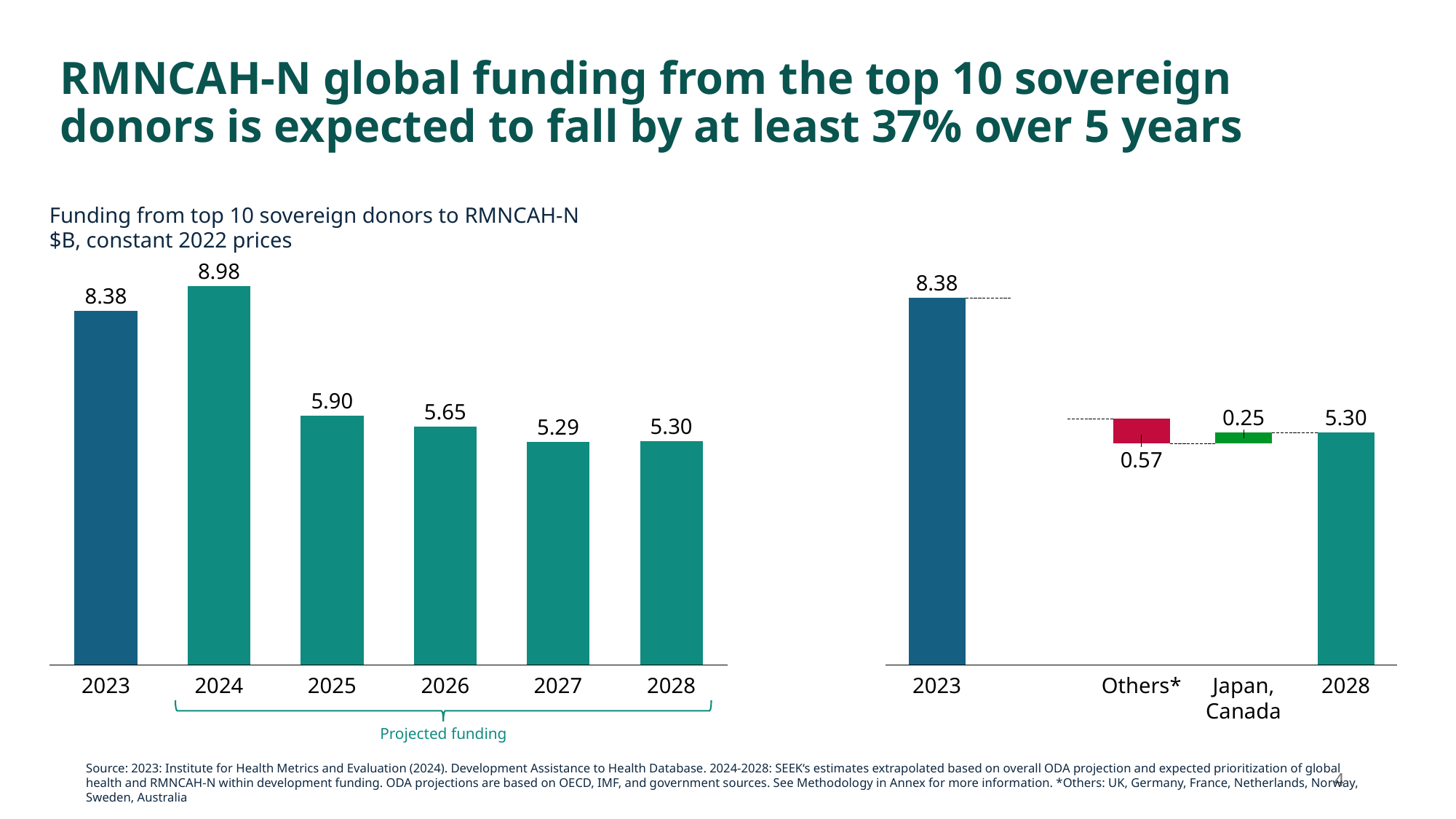
In the right chart, what is the value shown for Others*? 0.57 In the left chart, which is larger, the value for 2023 or the value for 2026? 2023 In the left chart, what is the difference between the 2024 and 2025 values? 3.08 In the left chart, which years are bracketed as 'Projected funding'? 2024 to 2028 In the left chart, do the values rise or fall from 2024 to 2027? Fall In the left chart, which year has the highest funding value? 2024 In the left chart, what is the funding value for 2024? 8.98 In the right chart, what is the value shown for Japan, Canada? 0.25 In the right chart, what is the value for 2028? 5.30 In the left chart, what is the funding value for 2027? 5.29 In the left chart, how many years are shown on the x axis? 6 What kind of chart is the left chart? Bar chart